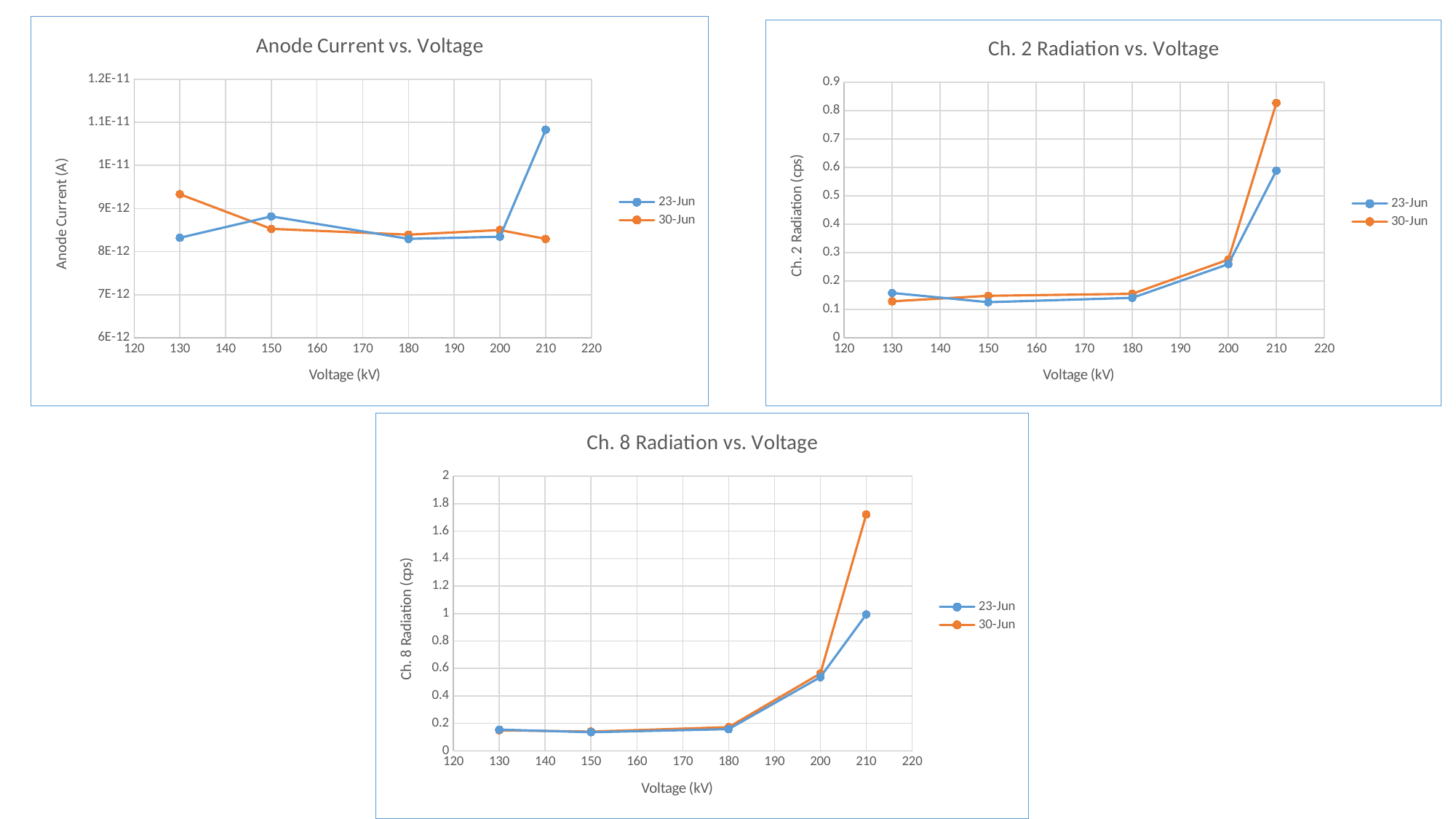
In the "Ch. 8 Radiation vs. Voltage" chart, how many data points does the 30-Jun series have? 5 In the "Ch. 8 Radiation vs. Voltage" chart, is the 30-Jun value at 210 kV greater or less than 1.6? greater In the "Anode Current vs. Voltage" chart, at 130 kV, which series has the larger value, 23-Jun or 30-Jun? 30-Jun How many series does the legend of the "Ch. 2 Radiation vs. Voltage" chart list? 2 In the "Ch. 2 Radiation vs. Voltage" chart, is the 30-Jun value at 210 kV greater or less than 0.8? greater In the "Anode Current vs. Voltage" chart, at which voltage does the 23-Jun series reach its highest value? 210 What is the x-axis label of the "Ch. 8 Radiation vs. Voltage" chart? Voltage (kV) In the "Ch. 8 Radiation vs. Voltage" chart, does the 30-Jun series rise or fall between 180 kV and 210 kV? rise In the "Anode Current vs. Voltage" chart, is the 30-Jun value at 210 kV greater or less than 9E-12? less In the "Ch. 2 Radiation vs. Voltage" chart, at 210 kV, which series has the larger value, 23-Jun or 30-Jun? 30-Jun What kind of chart is the "Anode Current vs. Voltage" chart? line chart